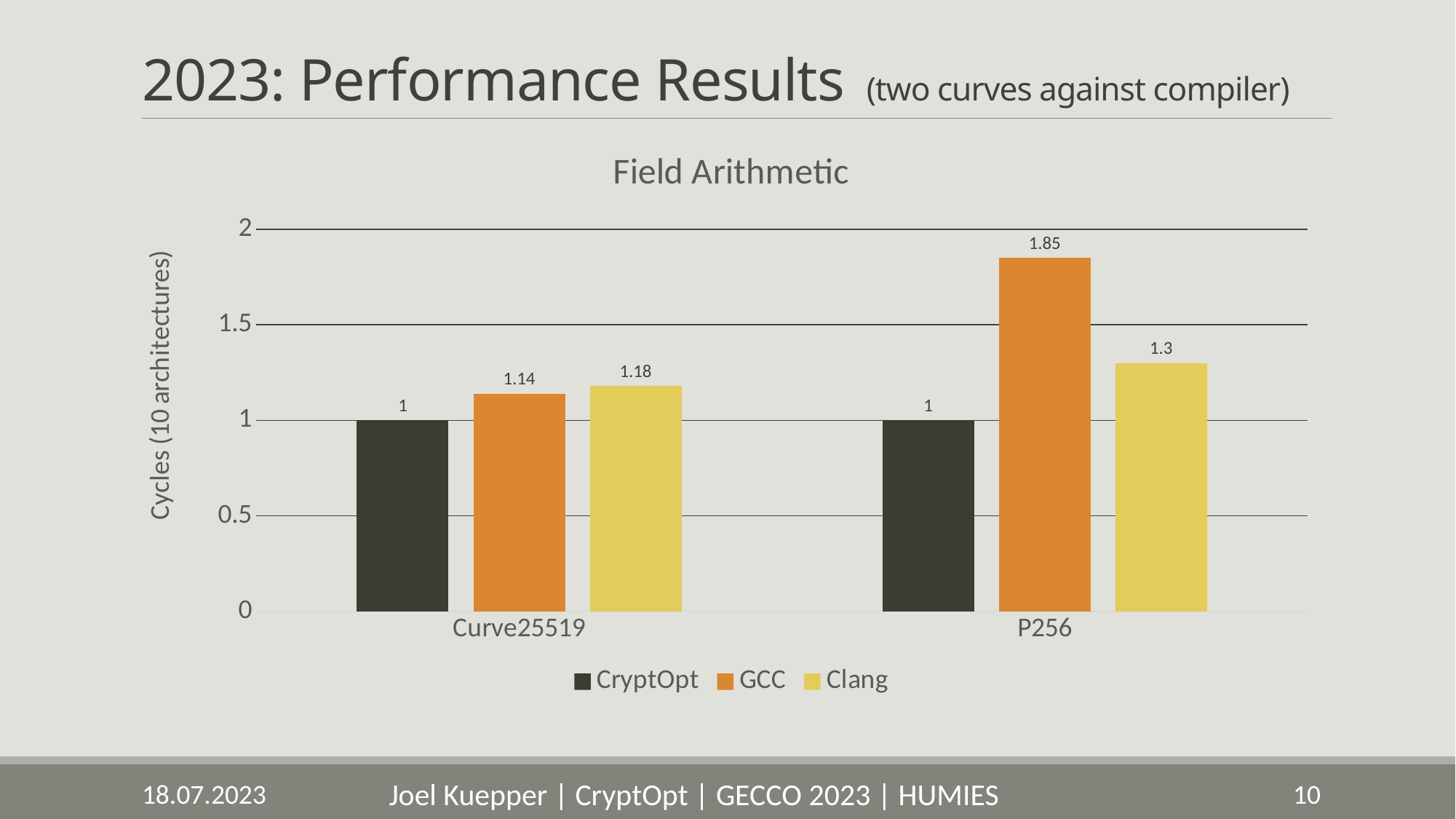
What is the value for Clang on P256? 1.3 What is the value for GCC on Curve25519? 1.14 Which series has the highest value for P256? GCC How many categories are shown on the x axis? 2 What is the difference between the GCC and CryptOpt values for P256? 0.85 How many series does the legend list? 3 What is the difference between the Clang and GCC values for Curve25519? 0.04 What is the value for CryptOpt on P256? 1 What kind of chart is shown on the slide? Bar chart Which series has the lowest value for Curve25519? CryptOpt Is the value for GCC on P256 greater or less than 1.5? greater Which is larger, the GCC value for P256 or the Clang value for P256? GCC